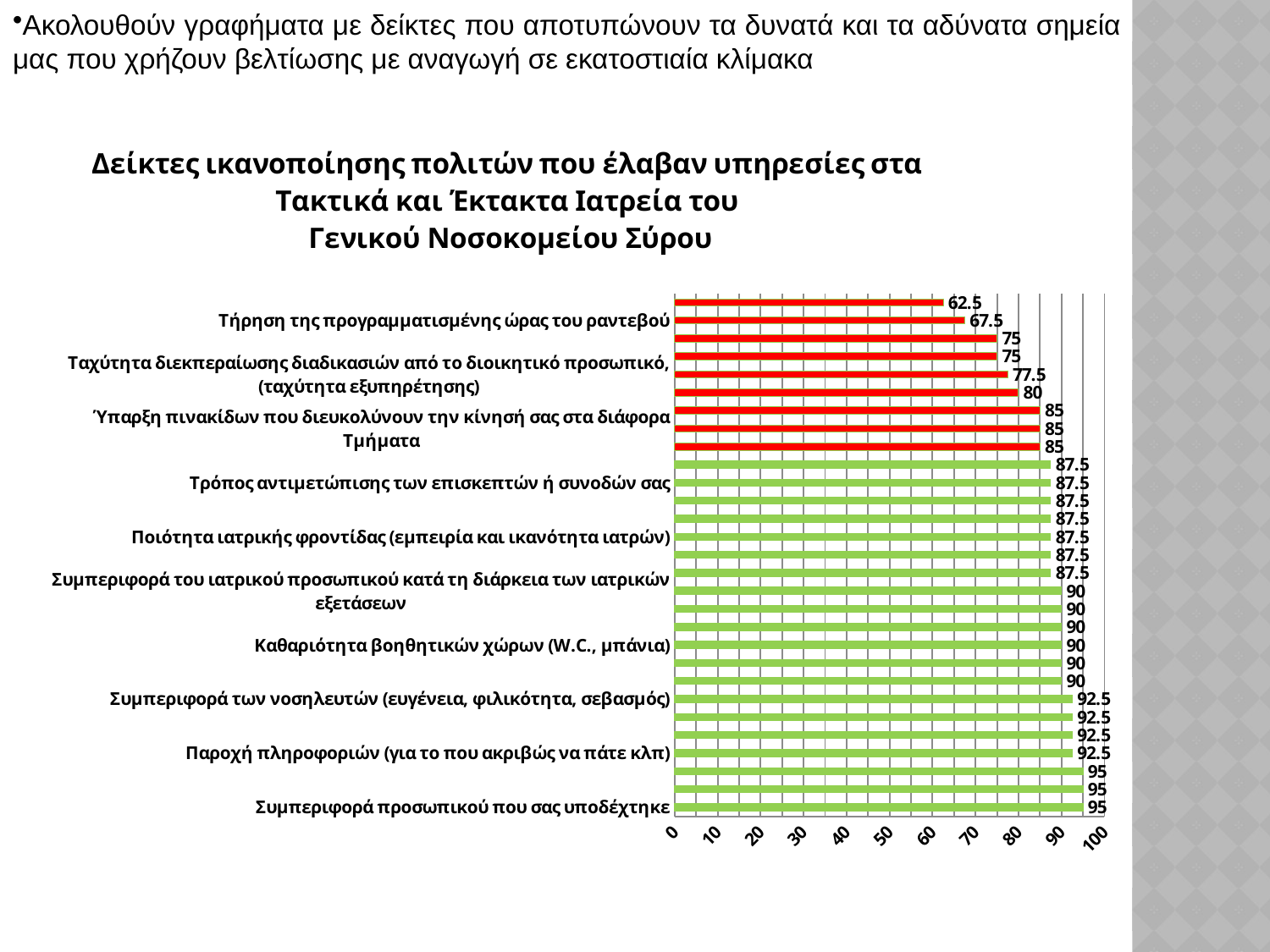
Is the value for 'Τήρηση της προγραμματισμένης ώρας του ραντεβού' greater or less than 70? less What is the value for 'Τήρηση της προγραμματισμένης ώρας του ραντεβού'? 67.5 What two colours are used for the bars in the chart? red and green What is the value for 'Ύπαρξη πινακίδων που διευκολύνουν την κίνησή σας στα διάφορα Τμήματα'? 85 Which is larger: the value for 'Παροχή πληροφοριών (για το που ακριβώς να πάτε κλπ)' or the value for 'Ποιότητα ιατρικής φροντίδας (εμπειρία και ικανότητα ιατρών)'? Παροχή πληροφοριών (για το που ακριβώς να πάτε κλπ) What is the difference between the value for 'Συμπεριφορά προσωπικού που σας υποδέχτηκε' and the value for 'Τήρηση της προγραμματισμένης ώρας του ραντεβού'? 27.5 What is the highest value shown in the chart? 95 What is the lowest value shown in the chart? 62.5 What is the value for 'Συμπεριφορά προσωπικού που σας υποδέχτηκε'? 95 What is the value for 'Καθαριότητα βοηθητικών χώρων (W.C., μπάνια)'? 90 What is the value for 'Συμπεριφορά των νοσηλευτών (ευγένεια, φιλικότητα, σεβασμός)'? 92.5 What type of chart is shown on the slide? bar chart